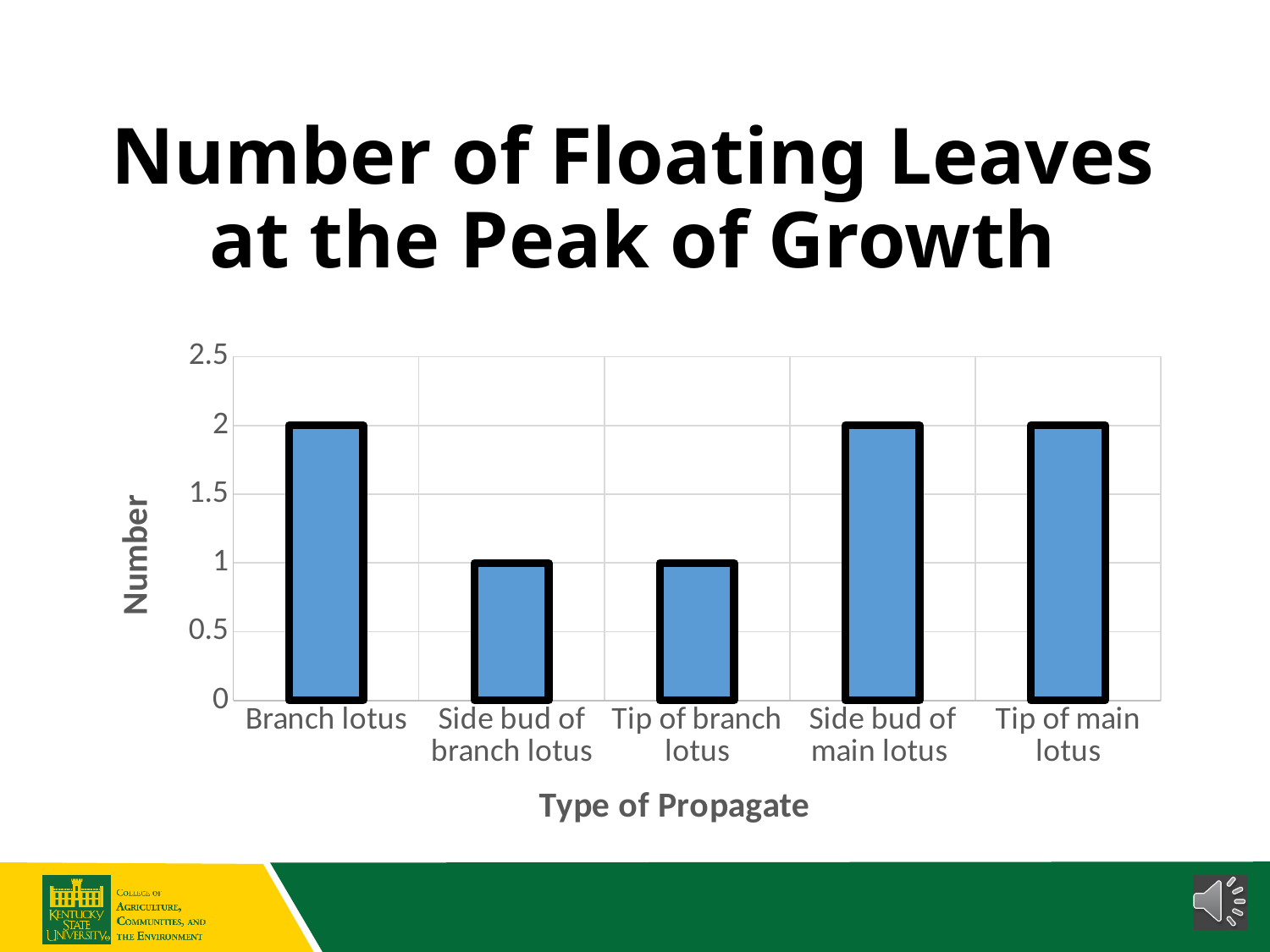
Is the value for Side bud of branch lotus greater or less than 1.5? less How many types of propagate are shown on the x axis? 5 Which has more floating leaves, Branch lotus or Side bud of branch lotus? Branch lotus What is the number of floating leaves for Branch lotus? 2 What is the title of the chart's x axis? Type of Propagate What is the number of floating leaves for Tip of branch lotus? 1 What is the number of floating leaves for Side bud of branch lotus? 1 What is the difference in number of floating leaves between Side bud of main lotus and Tip of branch lotus? 1 What is the number of floating leaves for Tip of main lotus? 2 Which has more floating leaves, Tip of branch lotus or Tip of main lotus? Tip of main lotus What is the number of floating leaves for Side bud of main lotus? 2 What type of chart is shown on the slide? bar chart